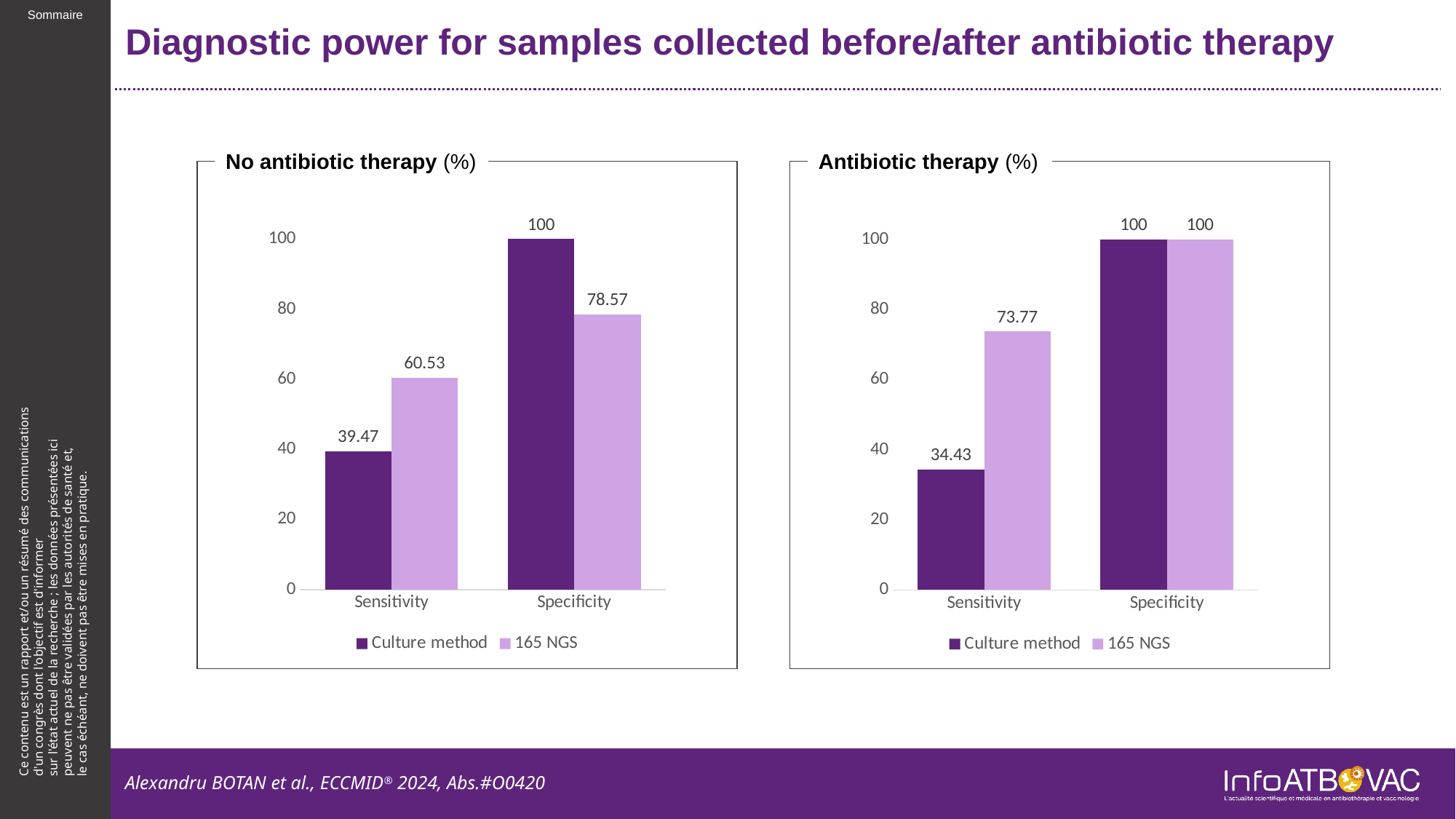
How many categories are shown on the x axis of the 'Antibiotic therapy (%)' chart? 2 How many series does the legend of the 'Antibiotic therapy (%)' chart list? 2 In the 'Antibiotic therapy (%)' chart, what is the sensitivity value for the Culture method? 34.43 In the 'Antibiotic therapy (%)' chart, which method has the higher sensitivity? 16S NGS In the 'Antibiotic therapy (%)' chart, what is the difference between the 16S NGS and Culture method sensitivity values? 39.34 What type of chart is the 'No antibiotic therapy (%)' chart? Bar chart In the 'No antibiotic therapy (%)' chart, what is the sensitivity value for the Culture method? 39.47 In the 'Antibiotic therapy (%)' chart, what is the sensitivity value for 16S NGS? 73.77 In the 'No antibiotic therapy (%)' chart, what is the difference between the 16S NGS and Culture method sensitivity values? 21.06 In the 'No antibiotic therapy (%)' chart, which method has the higher specificity? Culture method In the 'No antibiotic therapy (%)' chart, what is the specificity value for 16S NGS? 78.57 In the 'No antibiotic therapy (%)' chart, which bar has the lowest value? Culture method sensitivity